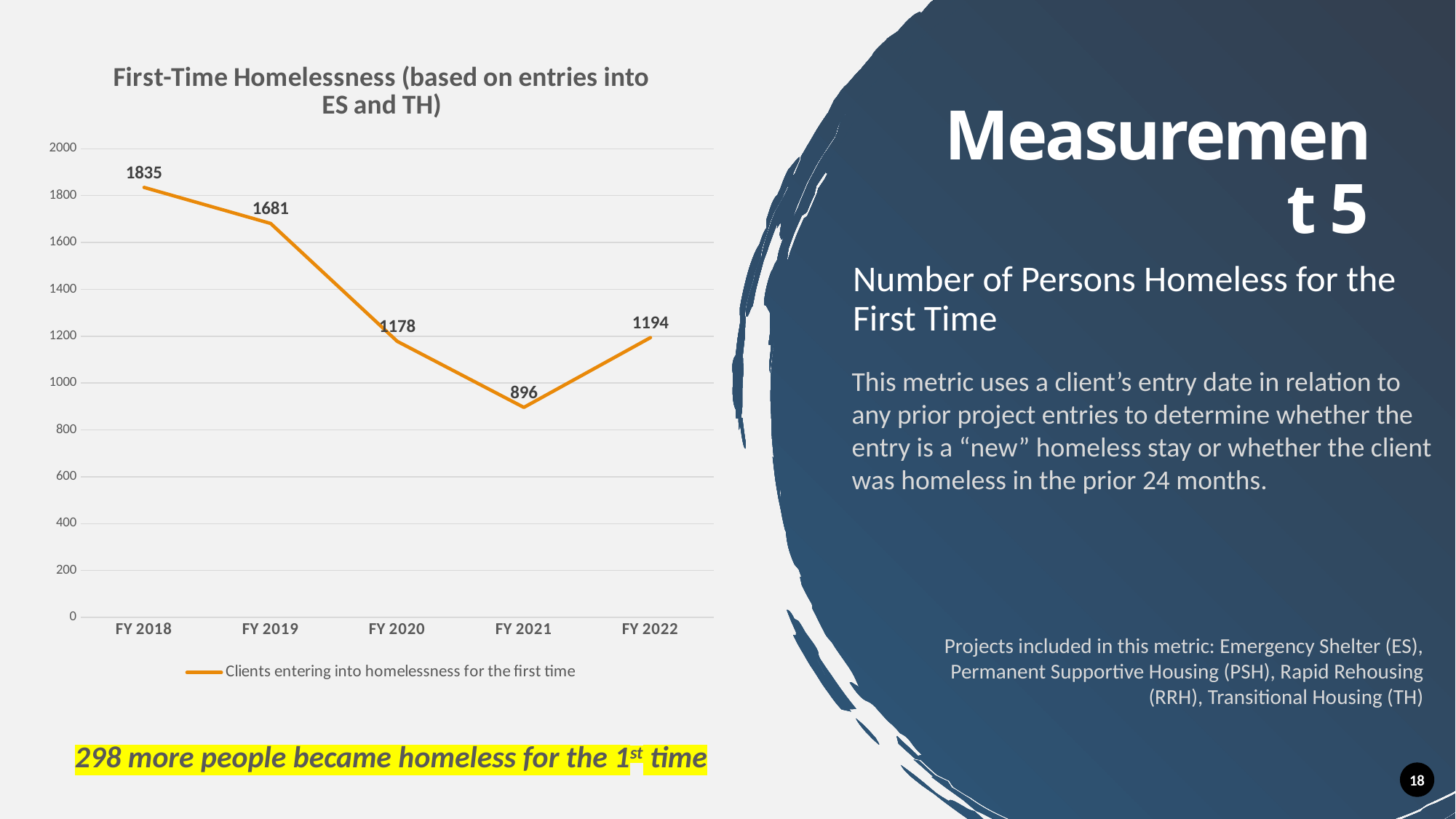
Which fiscal year has the lowest value? FY 2021 What is the value for FY 2022? 1194 Which is larger, the value for FY 2020 or the value for FY 2022? FY 2022 What is the title of the chart? First-Time Homelessness (based on entries into ES and TH) What is the value for FY 2021? 896 Which fiscal year has the highest value? FY 2018 What kind of chart is shown on the slide? line chart How many fiscal years are plotted on the chart? 5 Is the value for FY 2021 greater or less than 1000? less What is the value for FY 2018? 1835 What is the difference between the FY 2022 and FY 2021 values? 298 What is the difference between the FY 2018 and FY 2019 values? 154